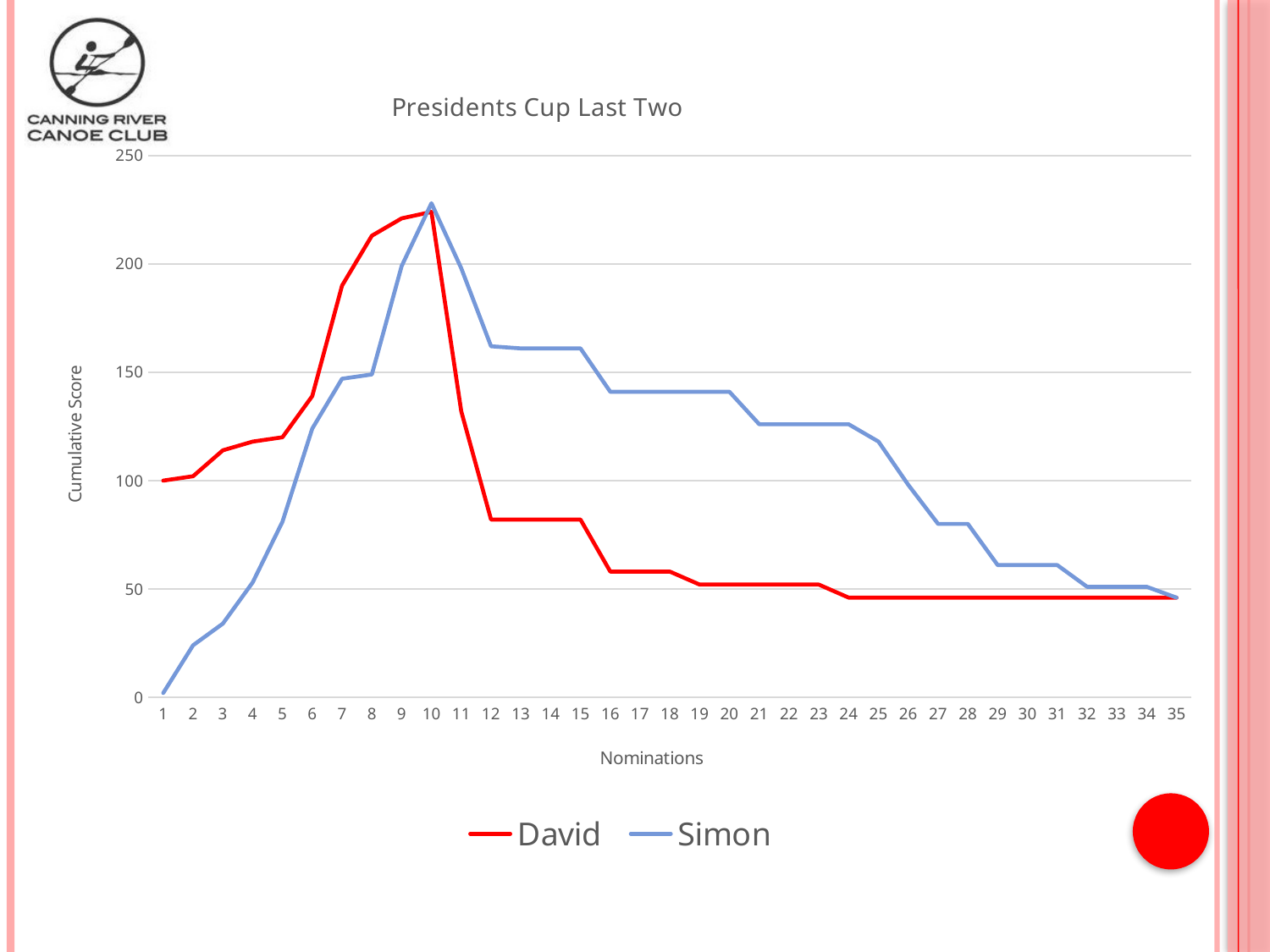
Is David's value at nomination 10 greater or less than 200? greater What kind of chart is shown on the slide? line chart At nomination 20, which series has the higher value, David or Simon? Simon How many series does the legend list? 2 What is the title of the chart? Presidents Cup Last Two Is Simon's value at nomination 20 greater or less than 150? less At nomination 5, which series has the higher value, David or Simon? David Does David's line rise or fall between nomination 10 and nomination 35? fall Is Simon's value at nomination 5 greater or less than 100? less How many nominations are plotted along the x axis? 35 What is David's cumulative score at nomination 1? 100